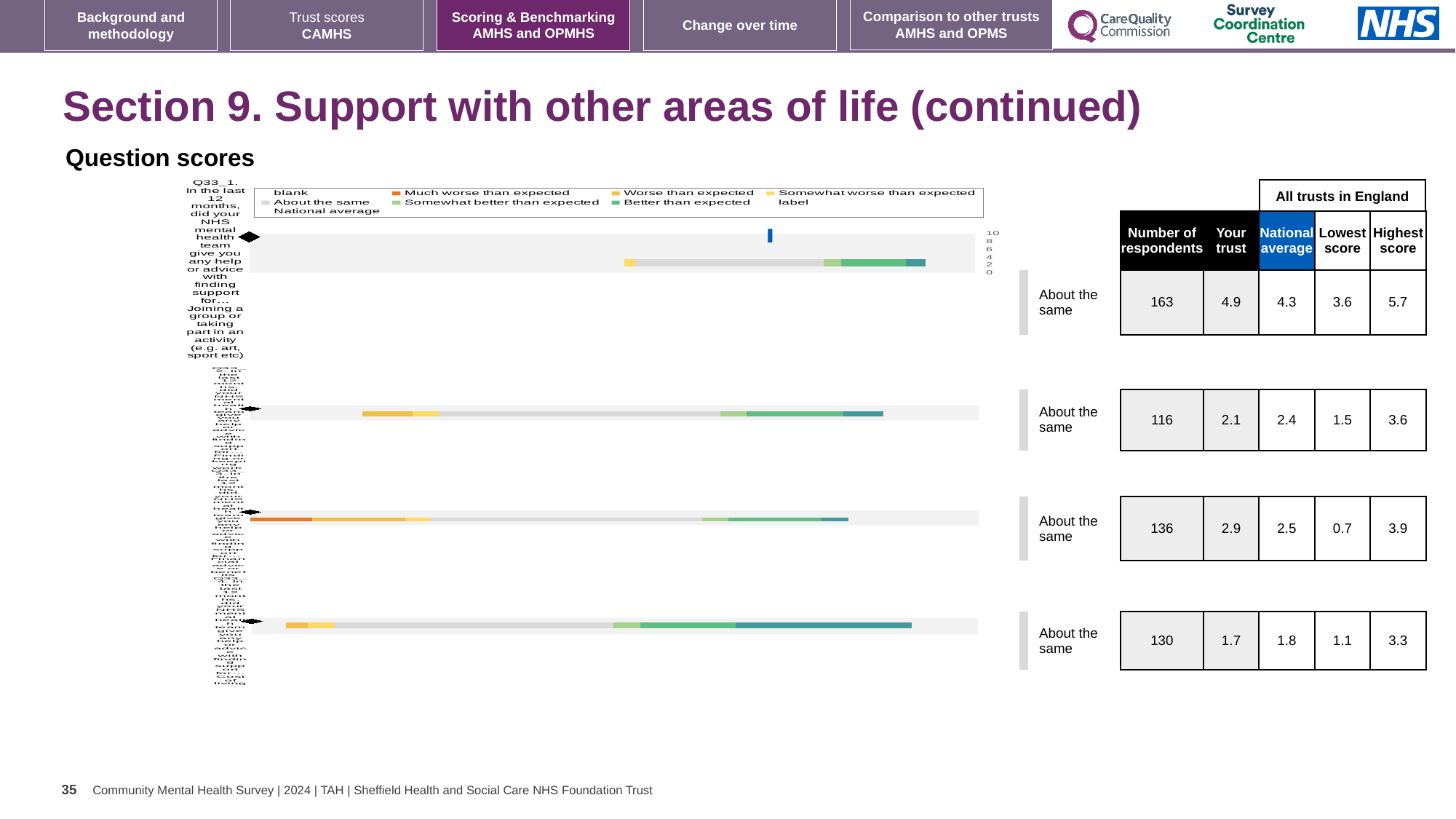
For the second bar, which is larger: the 'Your trust' score or the national average? National average Which of the four bars has the highest 'Your trust' score in the table beside the chart? the first bar (Q33_1) In the table beside the chart, what is the national average for the first bar (Q33_1)? 4.3 Which legend entry is shown in light grey? About the same In the table beside the chart, what is the 'Your trust' score for the first bar (Q33_1, joining a group or taking part in an activity)? 4.9 How many entries does the chart legend list? 9 Which of the four bars has the lowest 'Your trust' score in the table beside the chart? the fourth (bottom) bar What kind of chart is shown on the slide? bar chart What is the highest value shown on the chart's axis? 10 Which legend entry is shown in orange? Much worse than expected How many horizontal bars are plotted in the chart? 4 What is the difference between the 'Your trust' score and the national average for the first bar (Q33_1)? 0.6